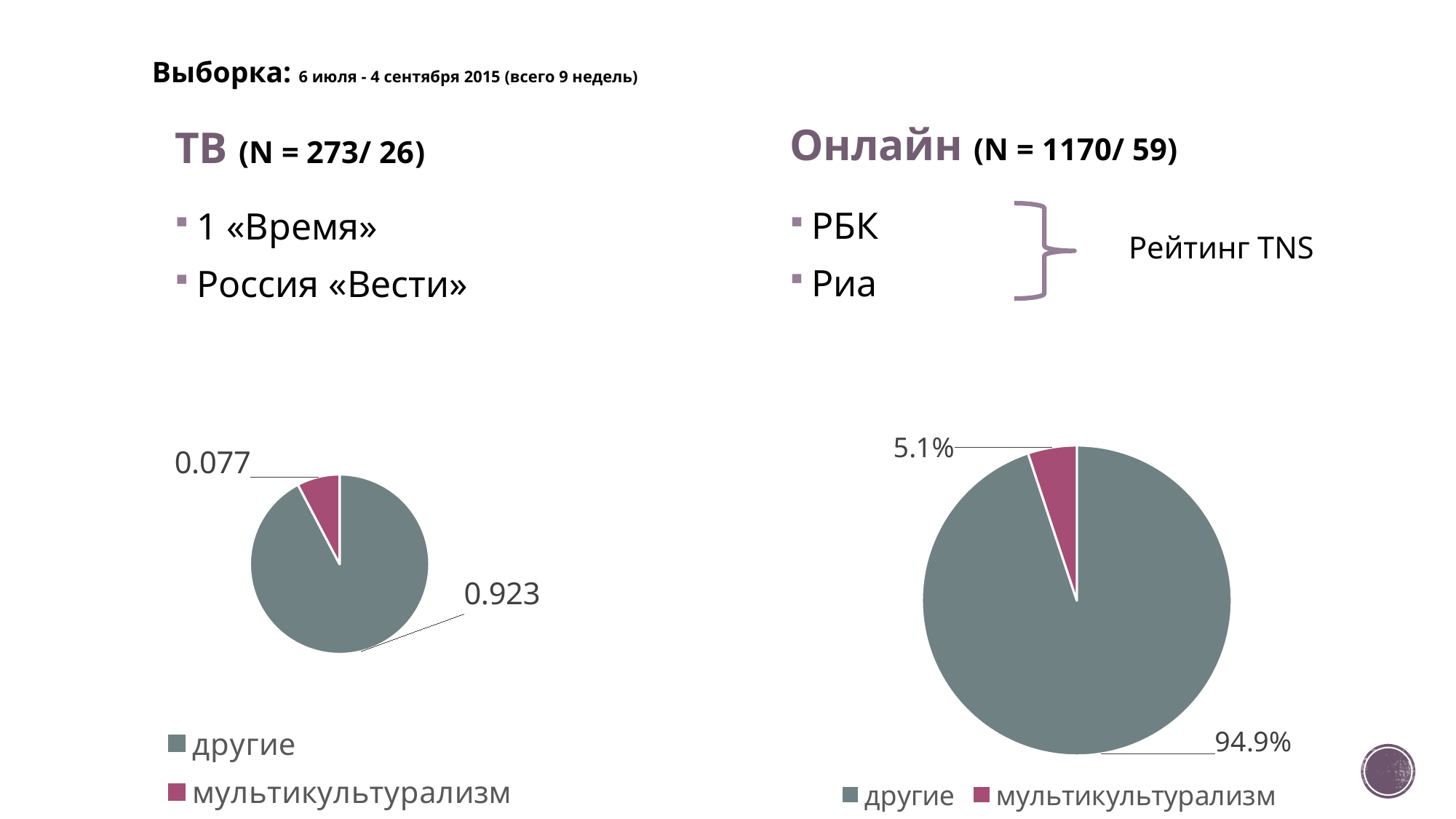
In the left pie chart, what is the difference between the «другие» and «мультикультурализм» values? 0.846 In the left pie chart, what colour is the «мультикультурализм» slice? magenta/purple In the right pie chart, what is the value for «мультикультурализм»? 5.1% In the right pie chart, what is the value for «другие»? 94.9% In the right pie chart, what is the difference between the «другие» and «мультикультурализм» slices? 89.8% In the left pie chart, which category has the smallest slice? мультикультурализм What kind of chart is shown on the left side of the slide? pie chart In the left pie chart, what is the value for «мультикультурализм»? 0.077 How many categories does the legend of the right pie chart list? 2 In the right pie chart, which category has the largest slice? другие In the left pie chart, which is larger: «другие» or «мультикультурализм»? другие In the left pie chart, what is the value for «другие»? 0.923